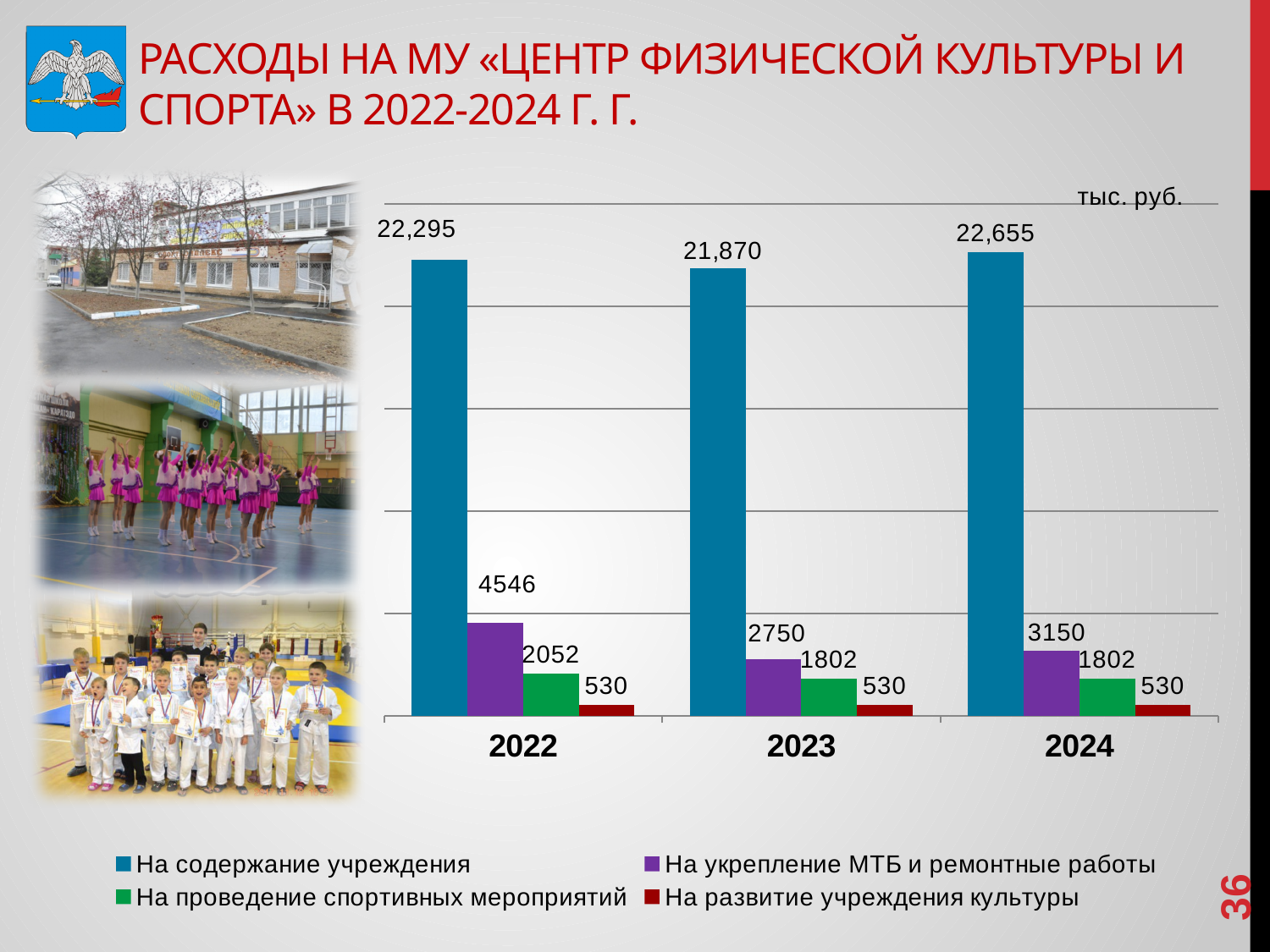
What type of chart is shown on the slide? bar chart In which year is the value for «На укрепление МТБ и ремонтные работы» the highest? 2022 What is the value for «На содержание учреждения» in 2022? 22,295 What unit is indicated in the top right corner of the chart? тыс. руб. How many series does the legend list? 4 How many years are shown on the x axis of the chart? 3 In which year is the value for «На содержание учреждения» the lowest? 2023 What is the difference between the «На содержание учреждения» values for 2024 and 2023? 785 Which is larger: «На укрепление МТБ и ремонтные работы» in 2023 or in 2024? 2024 What is the value for «На проведение спортивных мероприятий» in 2023? 1802 What is the value for «На развитие учреждения культуры» in 2022? 530 What is the value for «На укрепление МТБ и ремонтные работы» in 2024? 3150